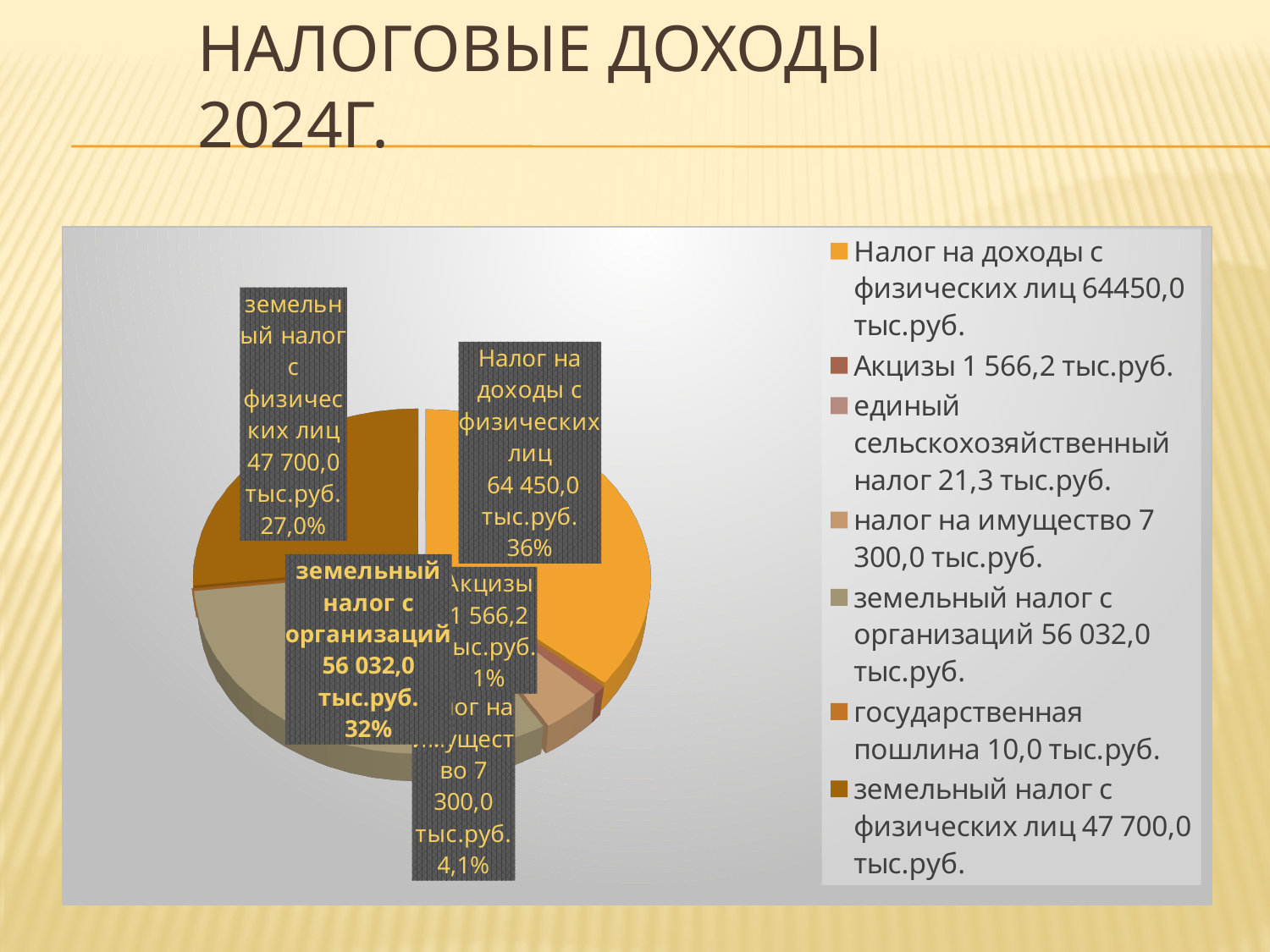
What is the difference between Налог на доходы с физических лиц and земельный налог с организаций? 8 418,0 тыс.руб. Which category has the largest value in the pie chart? Налог на доходы с физических лиц What share of the pie does налог на имущество represent? 4,1% What is the value for земельный налог с организаций? 56 032,0 тыс.руб. What kind of chart is shown on the slide? pie chart How many categories does the legend of the pie chart list? 7 What is the value for государственная пошлина? 10,0 тыс.руб. What is the value for Налог на доходы с физических лиц? 64 450,0 тыс.руб. Which is larger: земельный налог с организаций or земельный налог с физических лиц? земельный налог с организаций What share of the pie does земельный налог с физических лиц represent? 27,0% What is the value for единый сельскохозяйственный налог? 21,3 тыс.руб. Which category has the smallest value in the pie chart? государственная пошлина